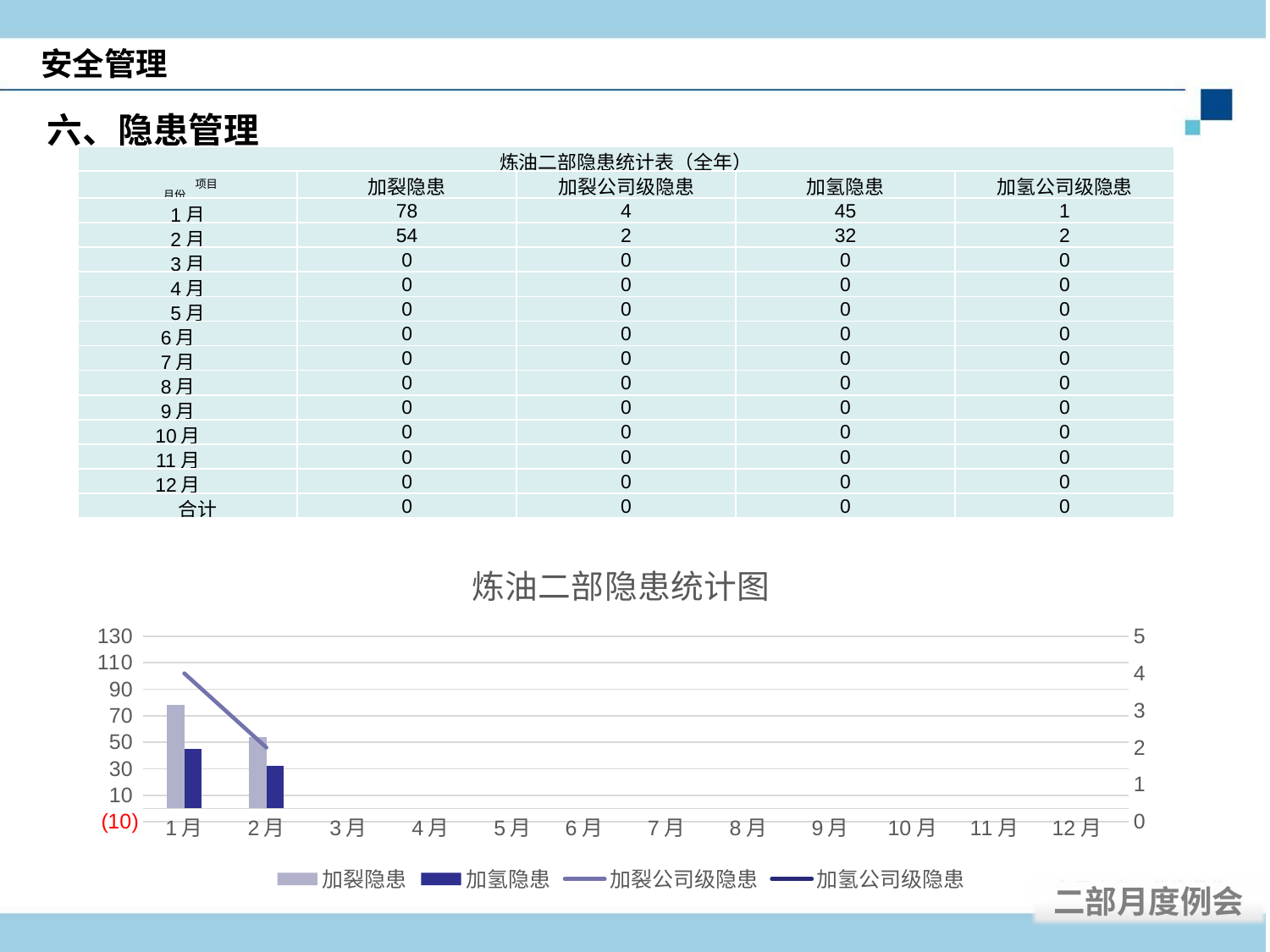
What is the title of the chart at the bottom of the slide? 炼油二部隐患统计图 What kind of chart is the 炼油二部隐患统计图? A combined bar and line chart In the 炼油二部隐患统计图, is the 加裂隐患 value for 1月 greater or less than 70? greater How many series does the legend of the 炼油二部隐患统计图 list? 4 In the 炼油二部隐患统计图, does the 加裂公司级隐患 line rise or fall from 1月 to 2月? fall In the 炼油二部隐患统计图, which month has the tallest 加裂隐患 bar? 1月 According to the slide, what is the 加裂隐患 value for 1月 plotted in the 炼油二部隐患统计图? 78 In the 炼油二部隐患统计图, is the 加氢隐患 value for 2月 greater or less than 50? less According to the slide, what is the difference between the 加裂隐患 values for 1月 and 2月 plotted in the 炼油二部隐患统计图? 24 How many months are shown on the x axis of the 炼油二部隐患统计图? 12 What is the highest tick value on the right-hand axis of the 炼油二部隐患统计图? 5 In the 炼油二部隐患统计图, which is larger in 1月: the 加裂隐患 bar or the 加氢隐患 bar? 加裂隐患